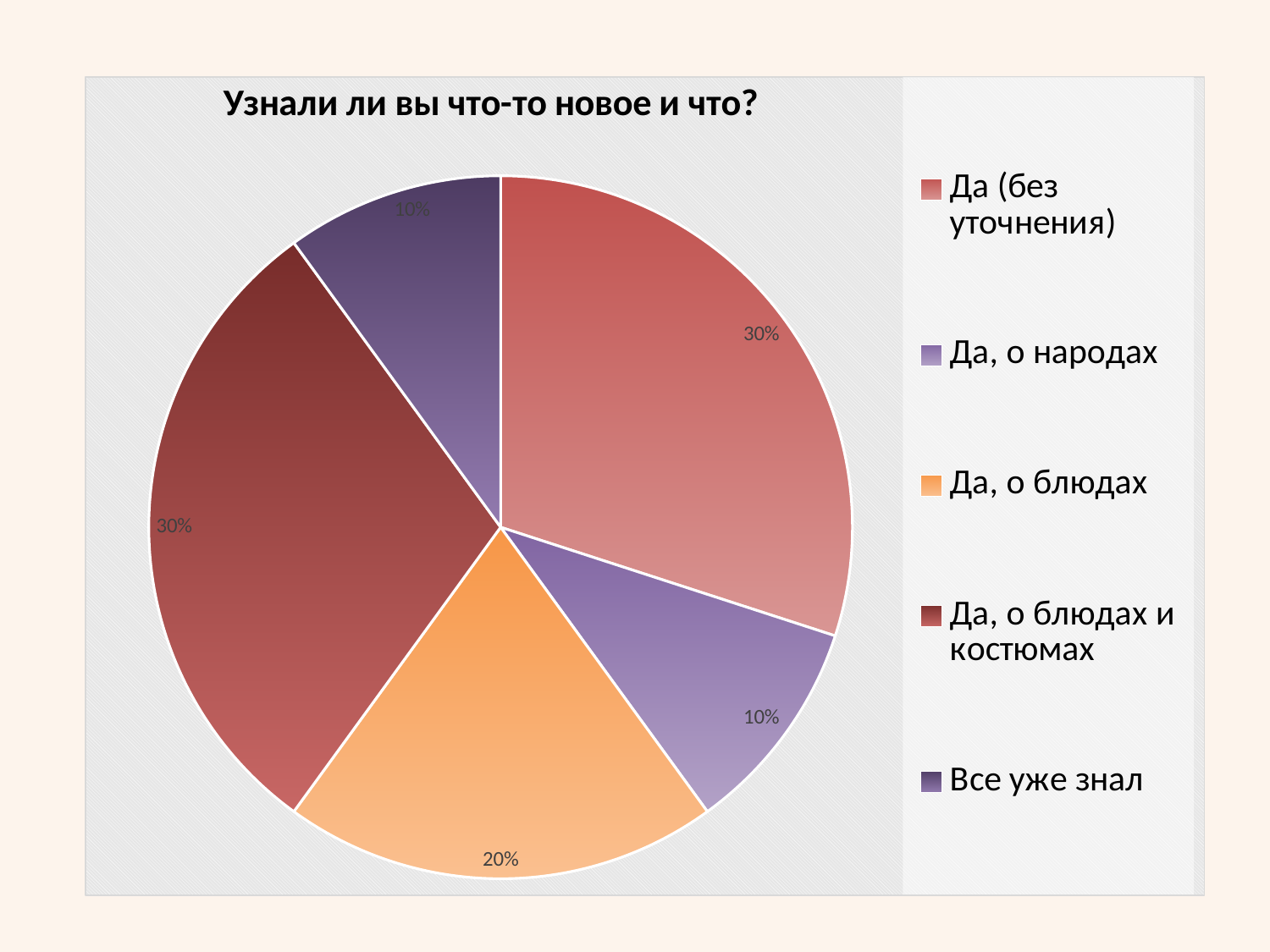
What share of the pie is "Да (без уточнения)"? 30% What share of the pie is "Да, о блюдах и костюмах"? 30% Which legend entry is listed last in the legend? Все уже знал What share of the pie is "Да, о блюдах"? 20% Which is larger: the share for "Да (без уточнения)" or the share for "Все уже знал"? Да (без уточнения) How many slices does the pie chart have? 5 What is the difference between the share for "Да, о блюдах и костюмах" and the share for "Да, о блюдах"? 10% What is the title of the chart? Узнали ли вы что-то новое и что? What type of chart is shown on the slide? pie chart Which is larger: the share for "Да, о блюдах" or the share for "Да, о народах"? Да, о блюдах